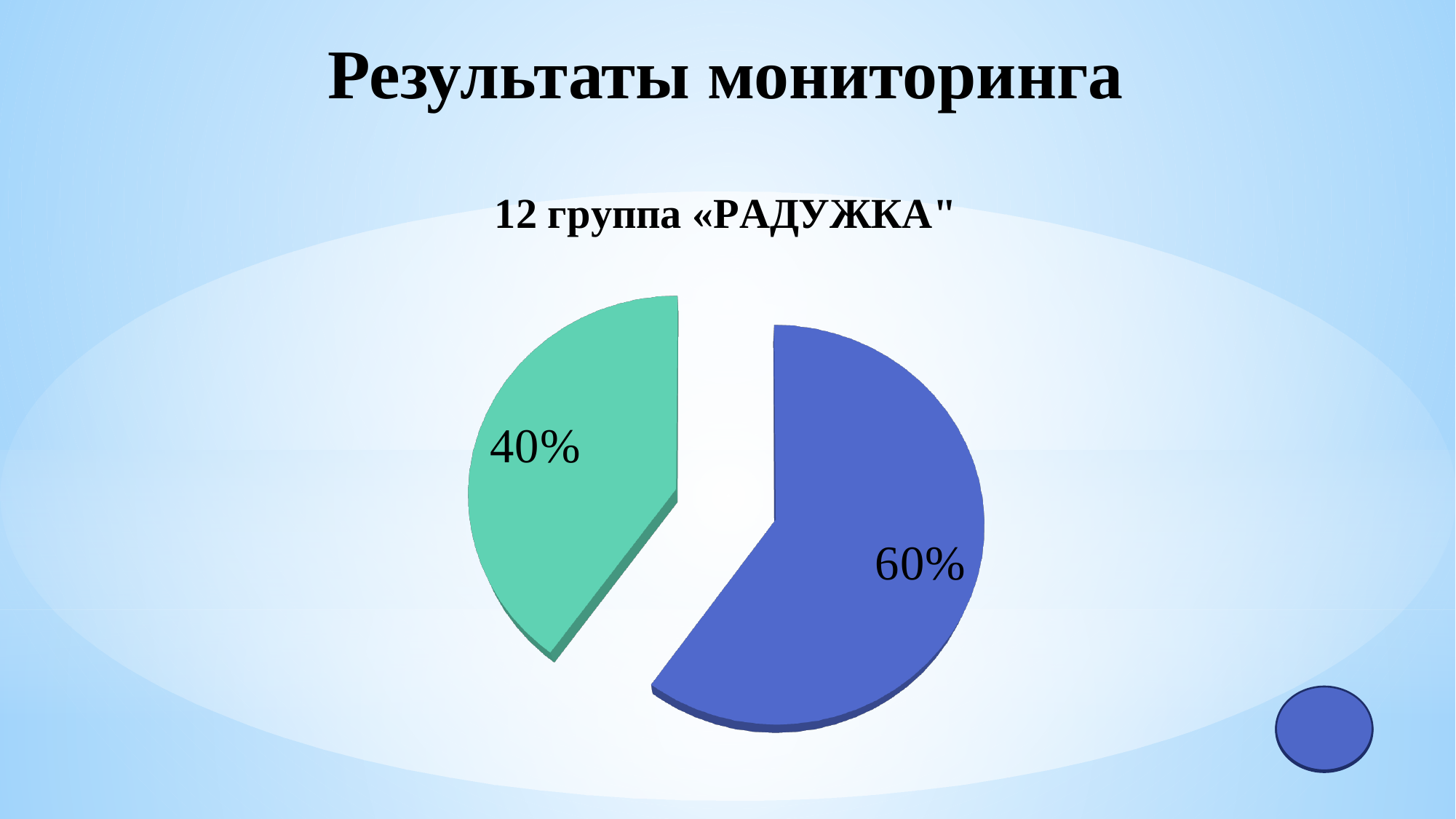
What is the value shown on the blue slice of the pie chart? 60% Is the value of the green slice greater or less than 50%? less What is the title of the pie chart? 12 группа «РАДУЖКА" How many slices does the pie chart have? 2 What kind of chart is shown on the slide? pie chart What is the value shown on the green slice of the pie chart? 40% Which is larger, the blue slice or the green slice? the blue slice What colour is the slice labelled 40%? green Which slice of the pie chart is the largest? the blue slice (60%) Which slice of the pie chart is the smallest? the green slice (40%) Is the value of the blue slice greater or less than 50%? greater What is the difference between the blue slice and the green slice? 20%